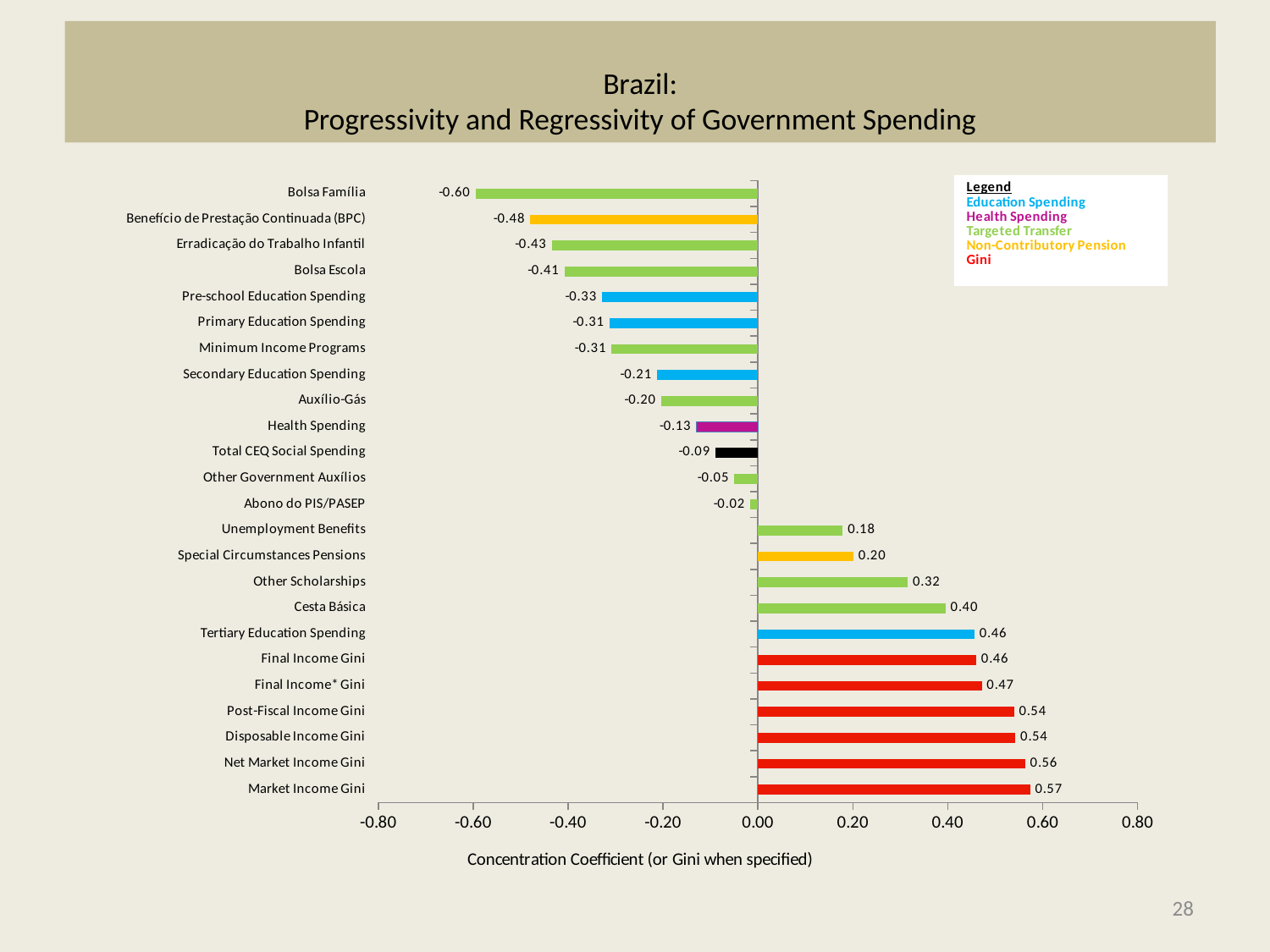
How many categories are plotted on the chart? 24 What is the difference between the Market Income Gini and the Final Income Gini? 0.11 Which category has the highest value? Market Income Gini Which category has the lowest value? Bolsa Família What is the value for Bolsa Família? -0.60 How many entries does the legend list? 5 Which is larger, the value for Other Scholarships or the value for Unemployment Benefits? Other Scholarships What is the value for Health Spending? -0.13 What kind of chart is shown on the slide? Bar chart What is the value for Cesta Básica? 0.40 What is the label of the horizontal axis? Concentration Coefficient (or Gini when specified) What is the value for Tertiary Education Spending? 0.46